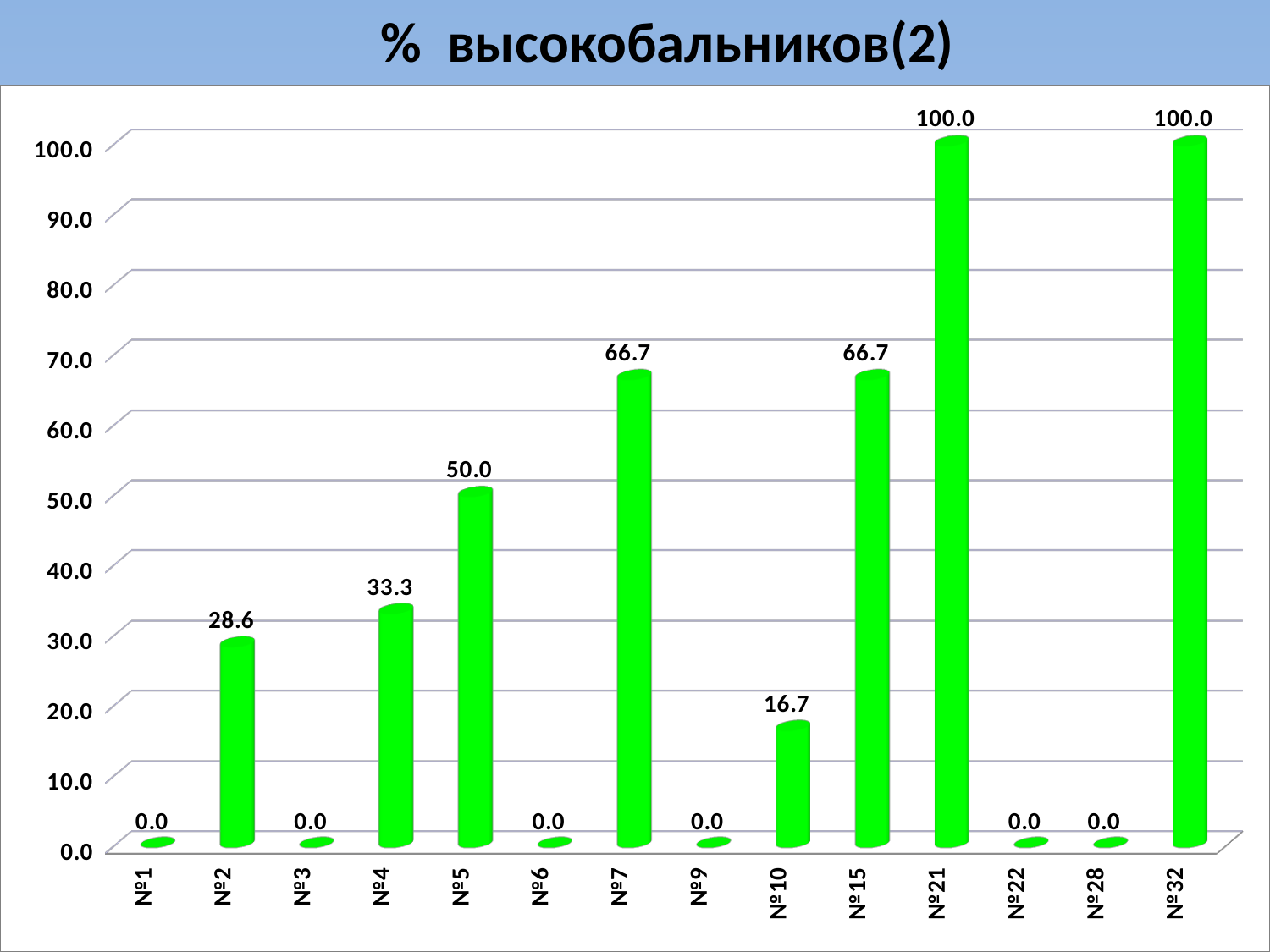
How many categories are shown on the x axis? 14 Which has a larger value, №4 or №2? №4 What is the value for №5? 50.0 What is the value for №2? 28.6 What kind of chart is shown on the slide? Bar chart What is the highest value shown on the chart? 100.0 What is the title of the chart? % высокобальников(2) What is the value for №21? 100.0 What is the value for №10? 16.7 What is the value for №7? 66.7 What is the difference between the values for №7 and №10? 50.0 What is the difference between the values for №5 and №4? 16.7